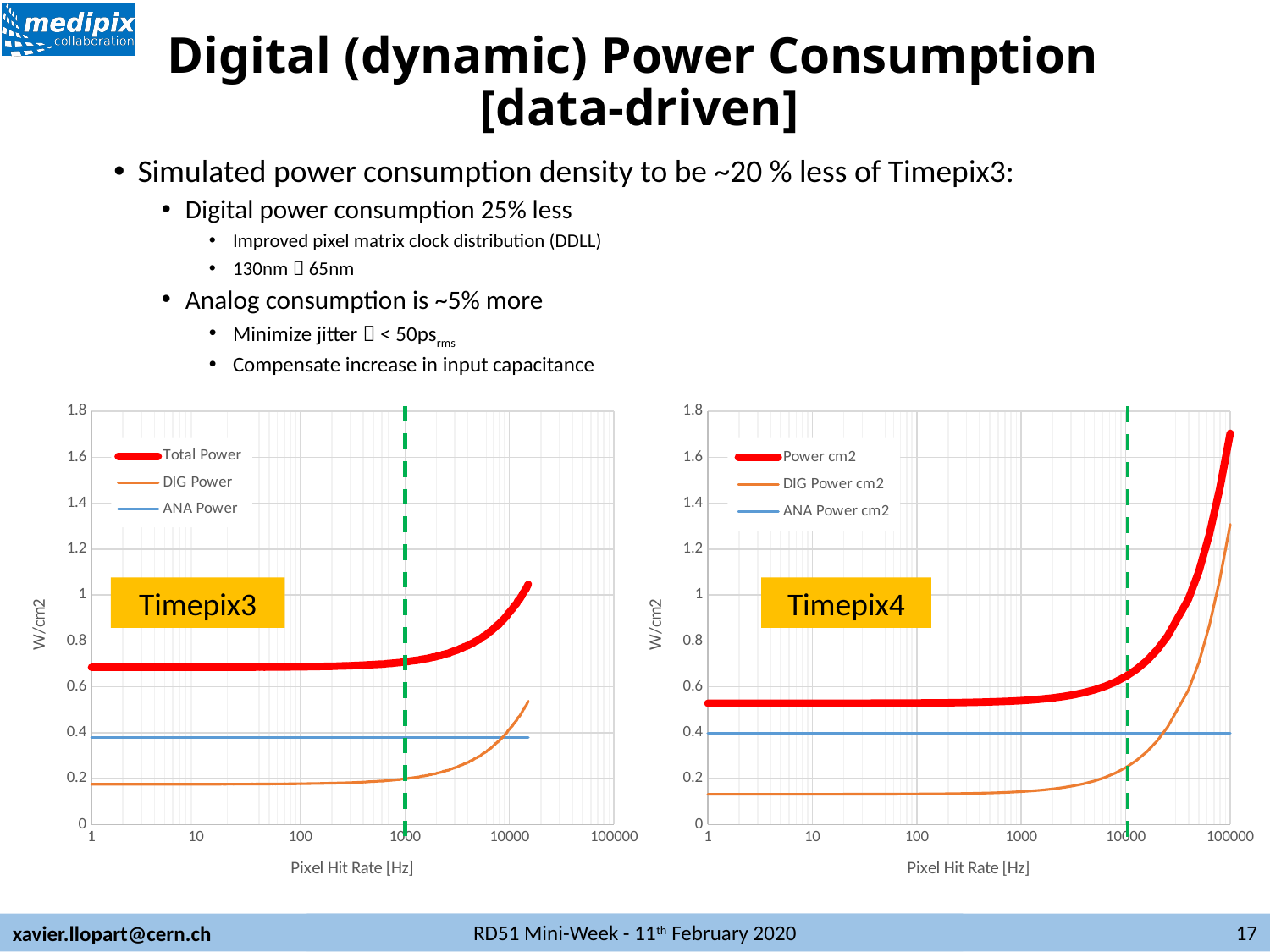
In the Timepix3 chart, what are the three series named in the legend? Total Power, DIG Power, ANA Power In the Timepix3 chart, is the Total Power value at a pixel hit rate of 1 Hz greater or less than 0.6 W/cm2? greater What kind of chart is the Timepix3 chart on the left? Line chart In the Timepix3 chart, is the ANA Power value greater or less than 0.4 W/cm2? less What is the x-axis title of the Timepix4 chart? Pixel Hit Rate [Hz] In the Timepix4 chart, is the DIG Power cm2 value at a pixel hit rate of 10 Hz greater or less than 0.2 W/cm2? less In the Timepix4 chart, does the ANA Power cm2 line rise, fall, or stay flat as the pixel hit rate increases? Stays flat How many series does the legend of the Timepix4 chart on the right list? 3 In the Timepix3 chart, does the Total Power line rise or fall as the pixel hit rate increases? Rises In the Timepix4 chart, at a pixel hit rate of 100000 Hz, which is larger: DIG Power cm2 or ANA Power cm2? DIG Power cm2